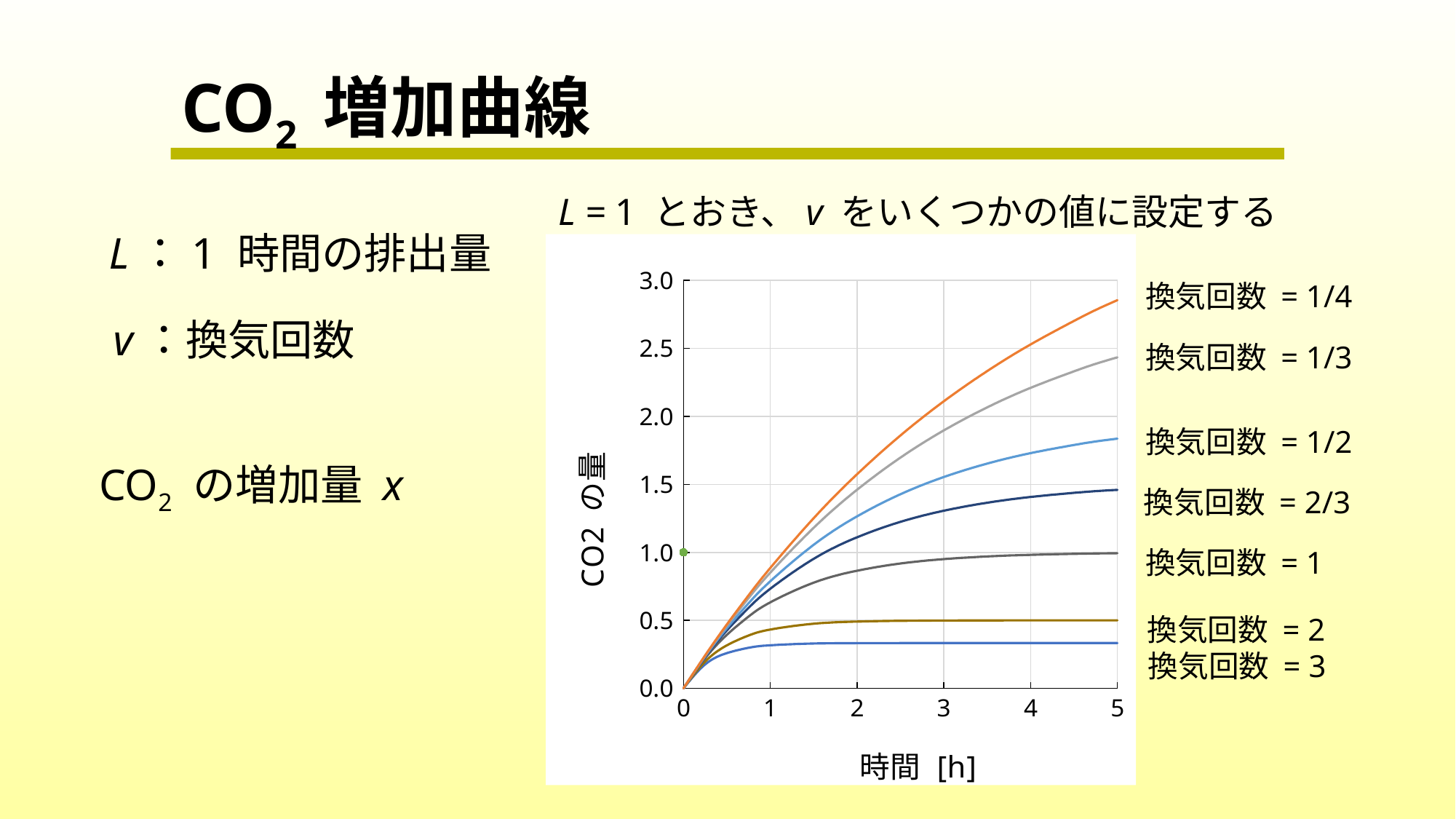
Is the value of the 換気回数 = 1/2 curve at 5 h greater or less than 2.0? less How many curves are plotted on the chart? 7 Which curve has the highest CO2 の量 at 5 h? 換気回数 = 1/4 What is the label of the y axis? CO2 の量 Is the value of the 換気回数 = 1 curve at 5 h greater or less than 0.5? greater Is the value of the 換気回数 = 1/4 curve at 5 h greater or less than 2.5? greater Which curve has the lowest CO2 の量 at 5 h? 換気回数 = 3 At 5 h, which curve is higher: 換気回数 = 1/3 or 換気回数 = 2/3? 換気回数 = 1/3 What kind of chart is shown on the slide? line chart What is the label of the x axis? 時間 [h] Do the curves rise or fall as 時間 increases from 0 to 5 h? rise